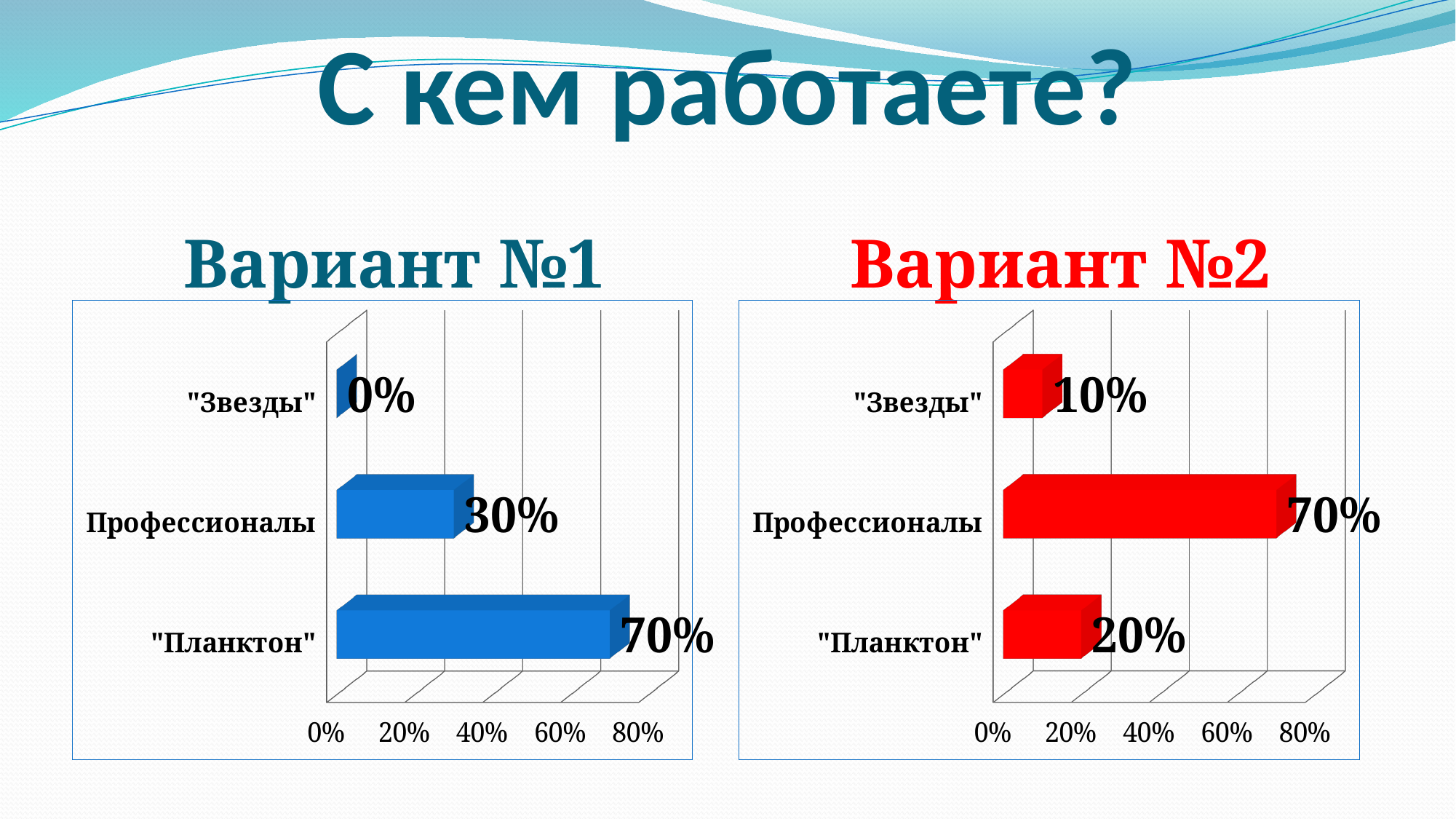
In the Вариант №1 chart, what is the difference between "Планктон" and Профессионалы? 40% In the Вариант №2 chart, which is larger, "Планктон" or "Звезды"? "Планктон" What colour are the bars in the Вариант №1 chart? Blue In the Вариант №2 chart, what is the value for "Планктон"? 20% In the Вариант №2 chart, which category has the lowest value? "Звезды" How many categories does the Вариант №1 chart show? 3 In the Вариант №2 chart, what is the difference between Профессионалы and "Планктон"? 50% In the Вариант №1 chart, what is the value for Профессионалы? 30% In the Вариант №1 chart, what is the value for "Планктон"? 70% In the Вариант №1 chart, which category has the highest value? "Планктон" What kind of chart is the Вариант №2 chart? Bar chart In the Вариант №2 chart, what is the value for "Звезды"? 10%